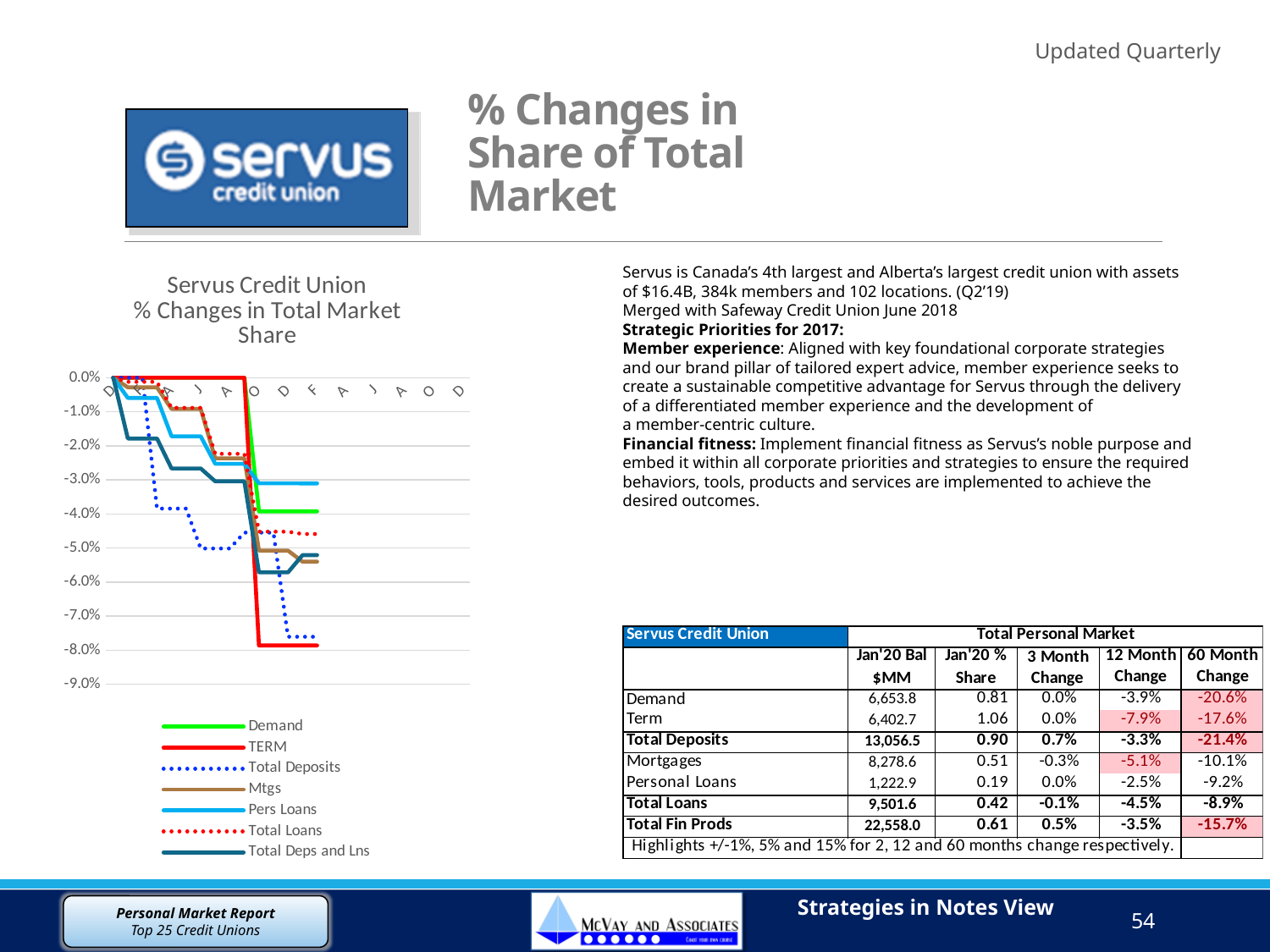
What kind of chart is shown on the slide? line chart What is the lowest value shown on the chart's y axis? -9.0% Which colour is used for the Demand series in the chart? green Is the final value of the TERM series greater or less than -7.0%? less At the right end of the chart, which series is higher: Pers Loans or Mtgs? Pers Loans How many series does the chart legend list? 7 Is the final value of the Mtgs series greater or less than -4.0%? less Is the final value of the Demand series greater or less than -5.0%? greater At the right end of the chart, which series is higher: Demand or TERM? Demand Do the plotted values generally rise or fall from left to right along the x axis? fall What is the title of the chart? Servus Credit Union % Changes in Total Market Share